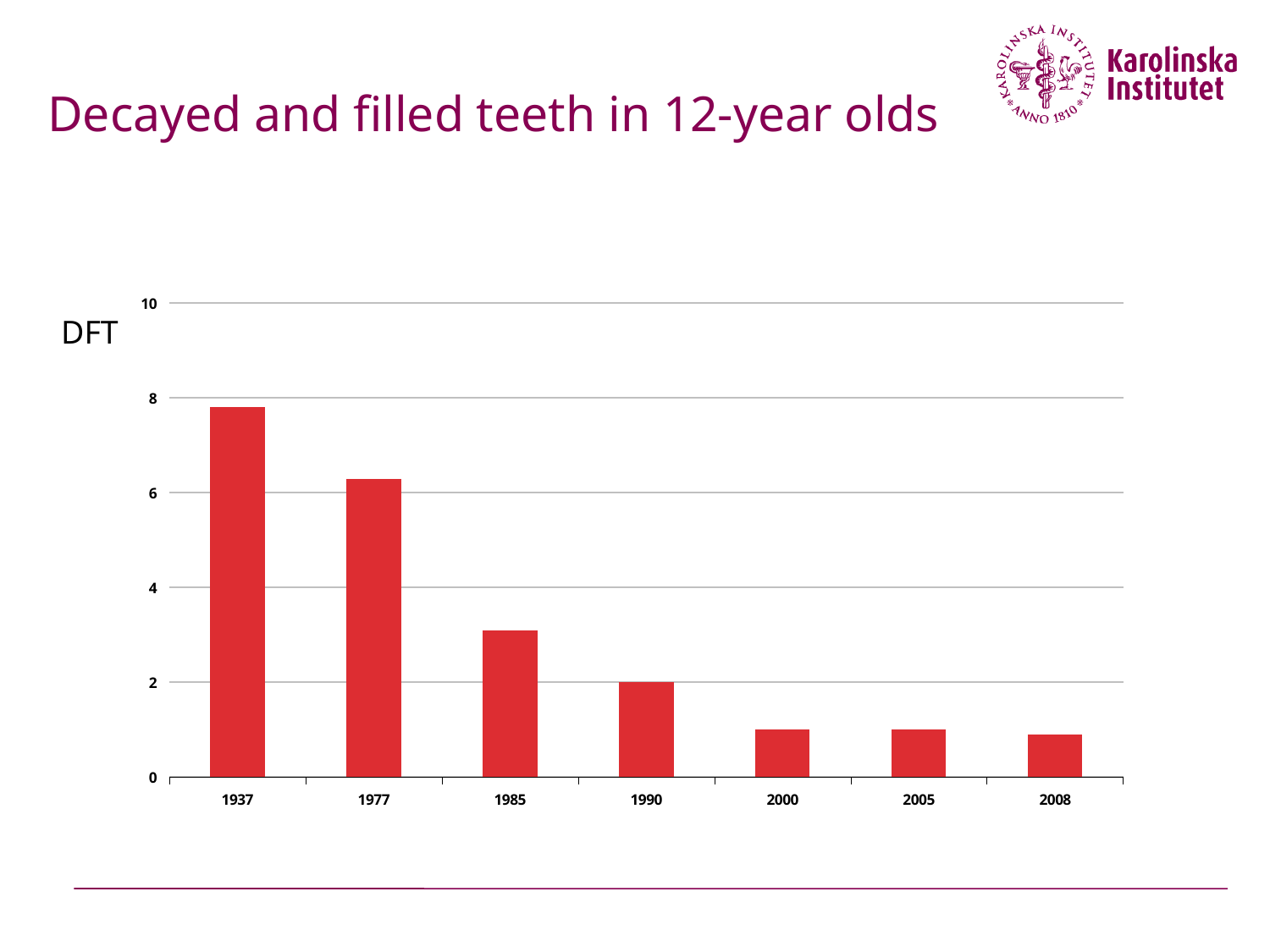
Is the DFT value for 1937 greater or less than 6? greater Do the DFT values rise or fall from 1937 to 2008? fall What is the title of the slide containing the chart? Decayed and filled teeth in 12-year olds Which year has the highest DFT value? 1937 Is the DFT value for 1977 greater or less than 6? greater Is the DFT value for 1985 greater or less than 4? less What kind of chart is shown on the slide? bar chart Which is larger, the DFT value for 1937 or for 1977? 1937 Which is larger, the DFT value for 1985 or for 1990? 1985 What label is shown on the vertical axis of the chart? DFT How many years are shown on the x axis of the chart? 7